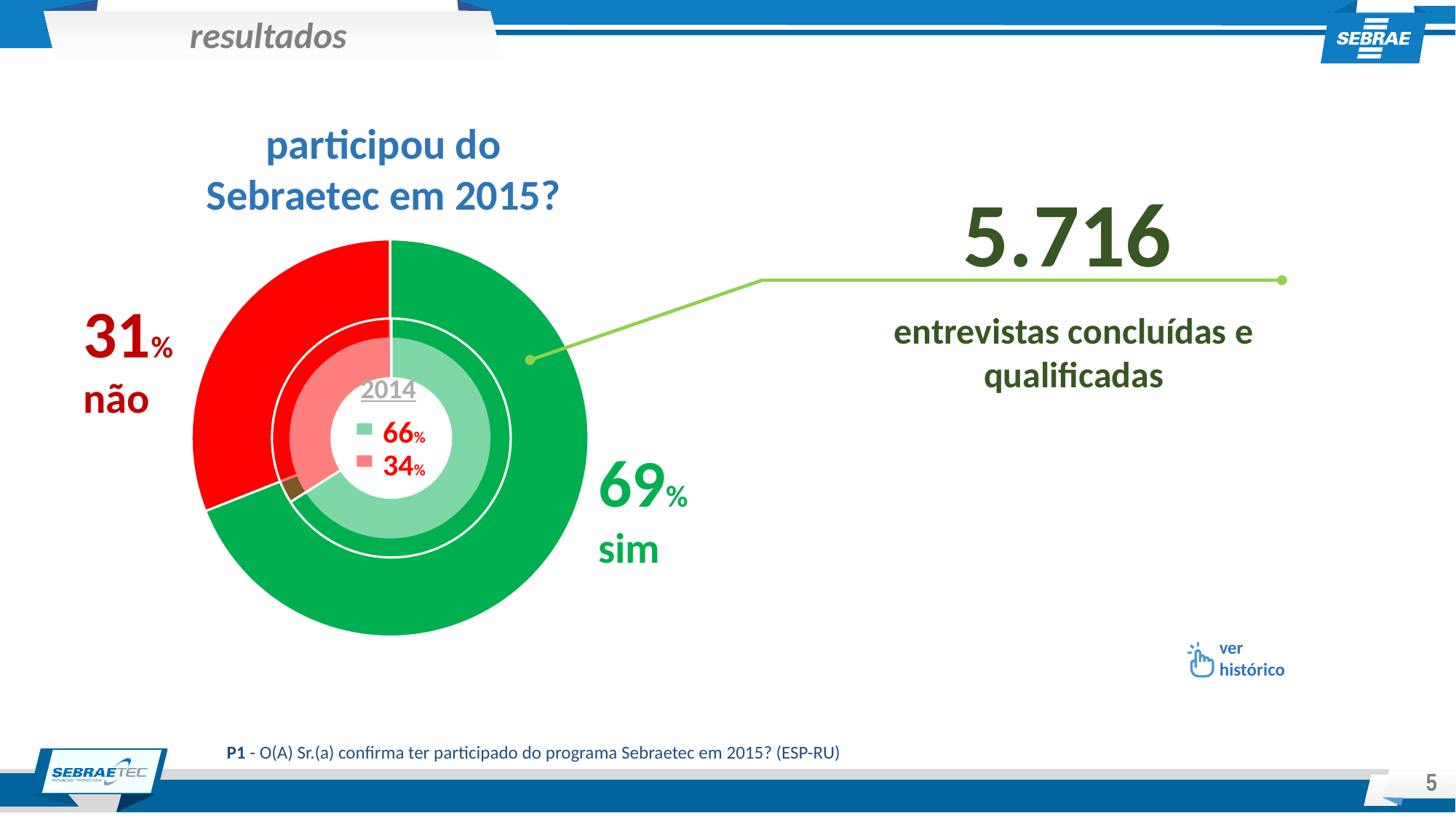
Which answer has the larger share in 2015, "sim" or "não"? sim Which answer has the smallest share in the 2015 outer ring? não In the inner 2014 ring, what percentage is shown for the green (sim) segment? 66% By how many percentage points did the "sim" share change from 2014 to 2015? 3 In the inner 2014 ring, what percentage is shown for the red (não) segment? 34% Did the "sim" share rise or fall from 2014 to 2015? rise How many categories does the chart show? 2 What share of respondents answered "sim" to participating in Sebraetec in 2015? 69% What kind of chart is used to show participation in Sebraetec in 2015? pie chart (donut) What is the difference in percentage points between "sim" and "não" in 2015? 38 What share of respondents answered "não" to participating in Sebraetec in 2015? 31% How many interviews were completed and qualified according to the slide? 5.716